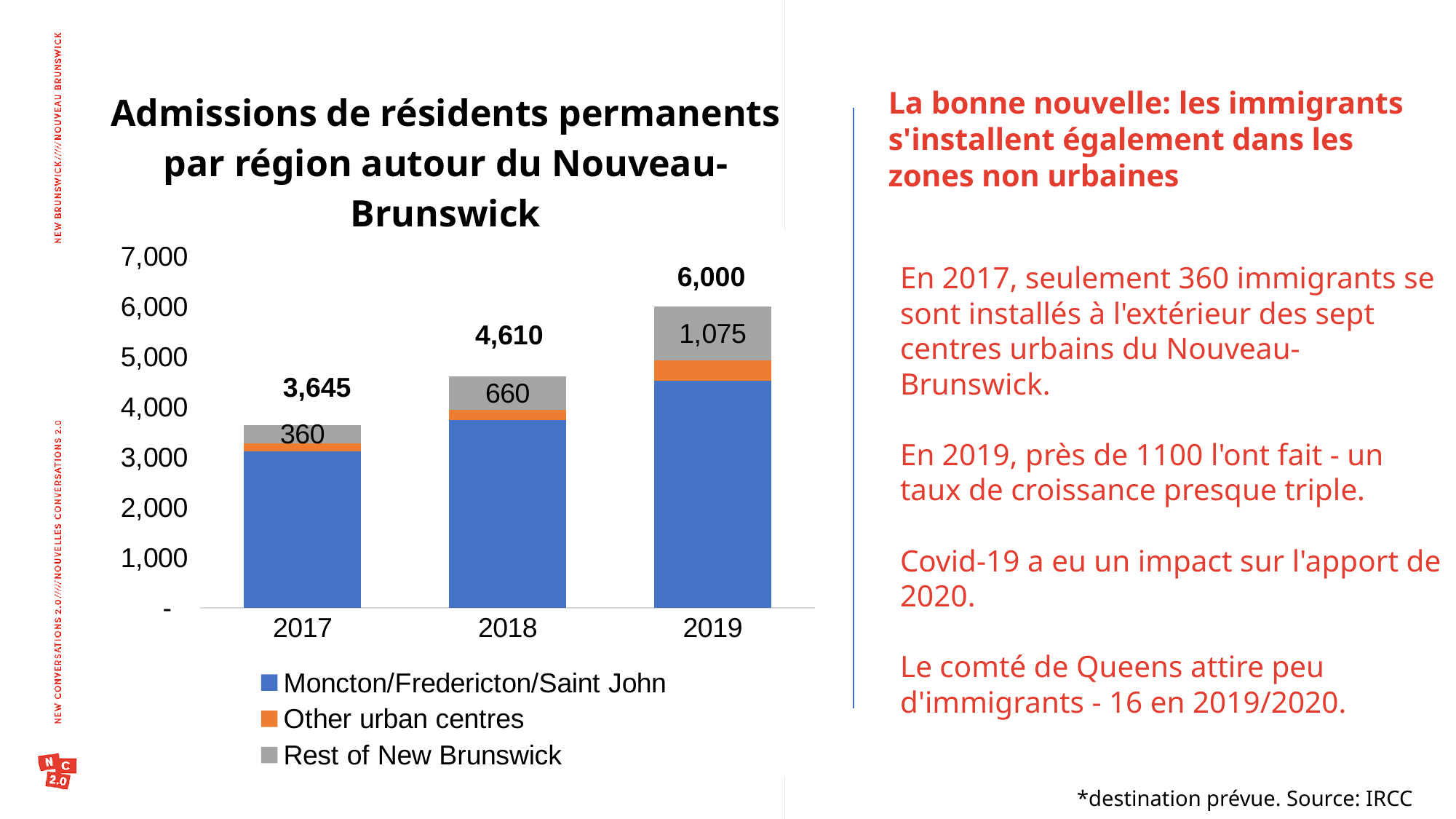
Which year has the lowest total admissions? 2017 How many years are shown on the x axis? 3 How many series does the legend list? 3 What value is labelled for Rest of New Brunswick in 2018? 660 Is the value for Moncton/Fredericton/Saint John in 2019 greater or less than 4,000? greater What is the difference between the total admissions in 2019 and in 2017? 2,355 What is the total number of permanent resident admissions shown for 2017? 3,645 What value is labelled for Rest of New Brunswick in 2019? 1,075 Which year has the highest total admissions? 2019 By how much did the Rest of New Brunswick value increase from 2017 to 2019? 715 What is the total number of permanent resident admissions shown for 2019? 6,000 Do the total admissions rise or fall from 2017 to 2019? rise